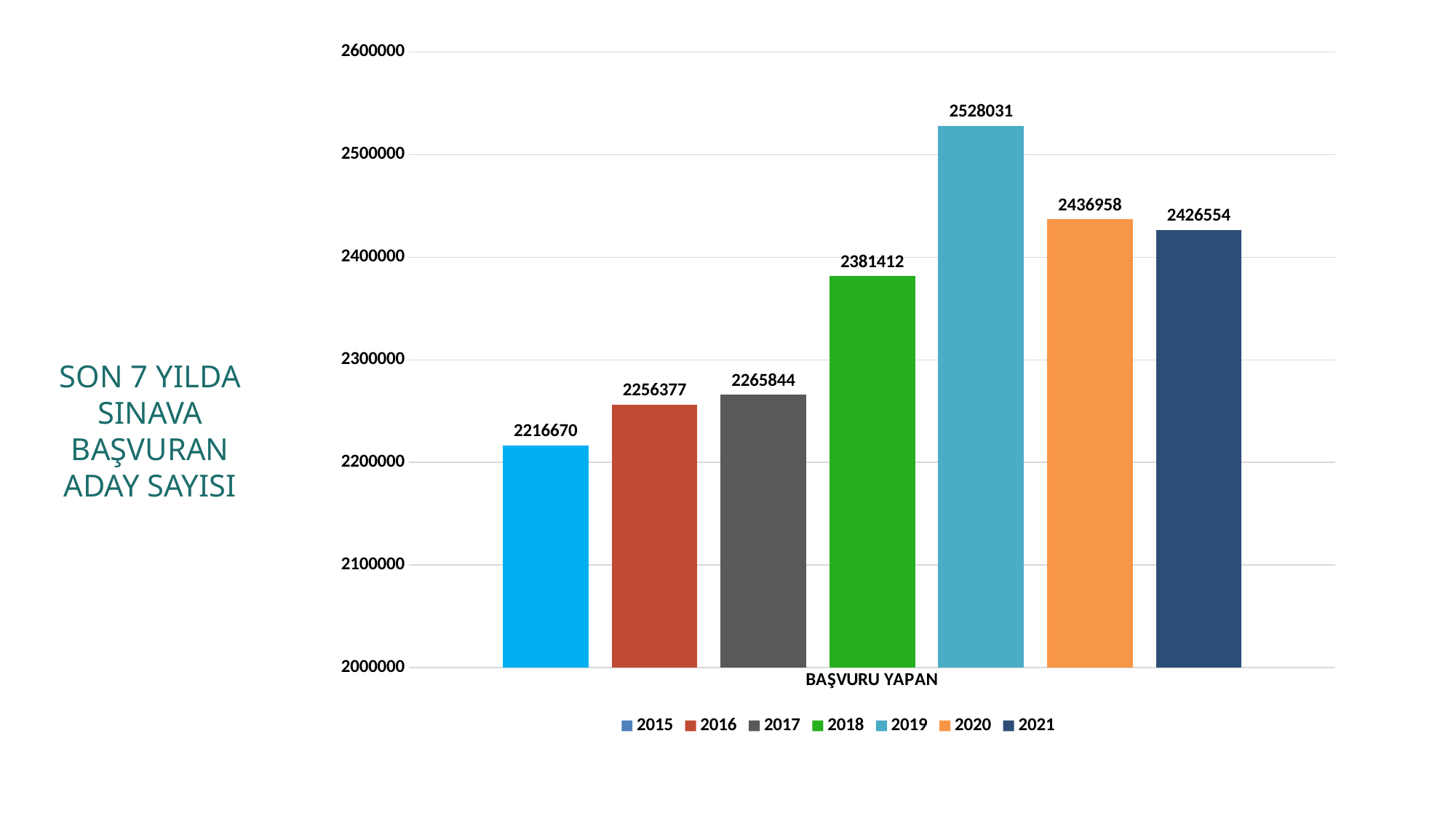
What kind of chart is shown on the slide? bar chart What is the value for 2015? 2216670 Which is larger, the value for 2018 or the value for 2017? 2018 What is the value for 2019? 2528031 What is the difference between the values for 2020 and 2021? 10404 Which year has the lowest value? 2015 Is the value for 2018 greater or less than 2400000? less What is the difference between the values for 2019 and 2015? 311361 What is the value for 2021? 2426554 How many series does the legend list? 7 Which year has the highest value? 2019 What is the label on the x axis of the chart? BAŞVURU YAPAN